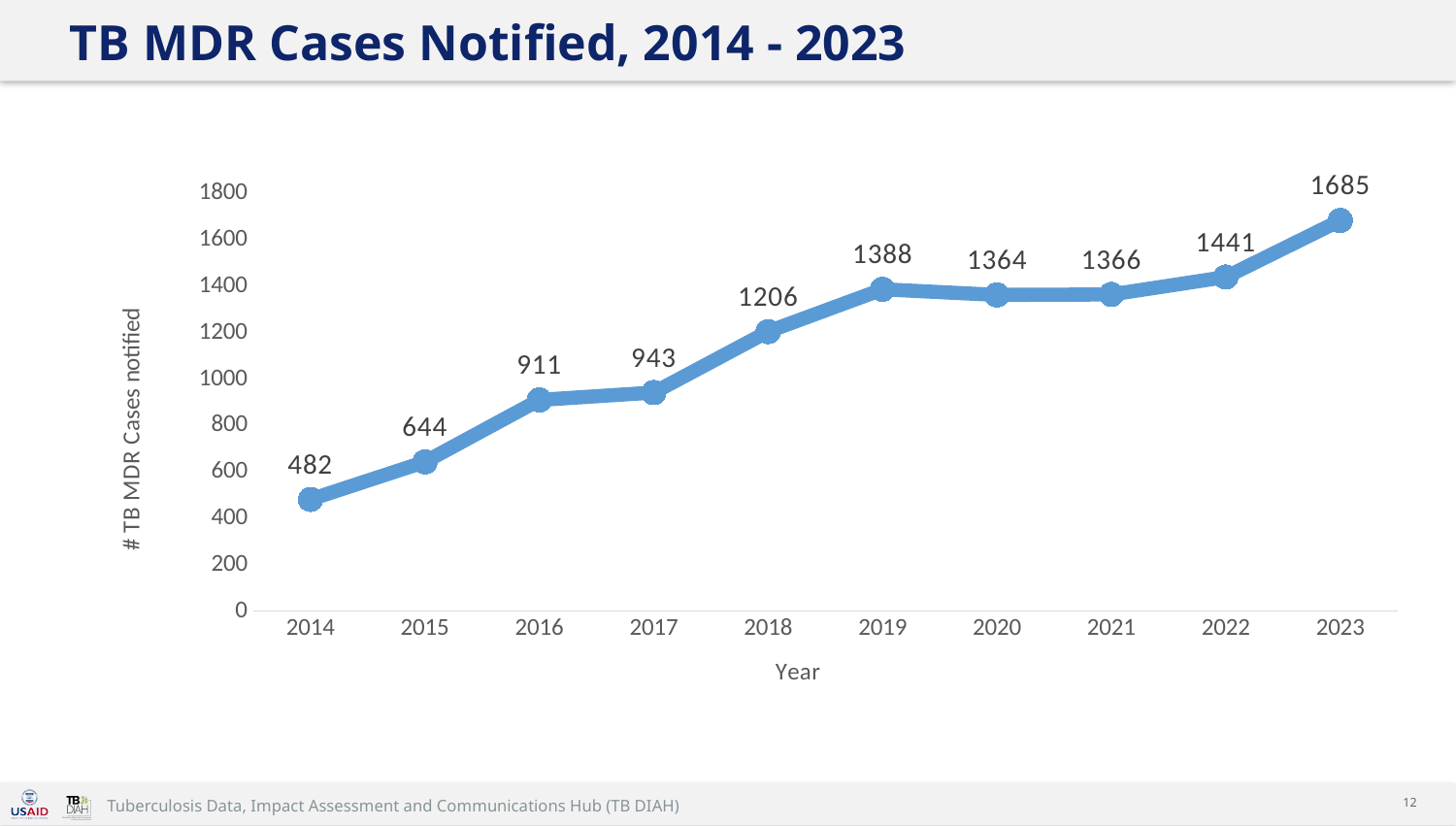
Which year had more TB MDR cases notified, 2016 or 2018? 2018 Which year has the lowest number of TB MDR cases notified? 2014 Which year has the highest number of TB MDR cases notified? 2023 What is the difference between the number of cases notified in 2023 and in 2014? 1203 What value is shown for 2022? 1441 What is the overall trend in TB MDR cases notified from 2014 to 2023? Rising How many years are plotted on the chart? 10 How many TB MDR cases were notified in 2014? 482 What kind of chart is shown on the slide? Line chart Is the value for 2015 greater or less than 800? less By how much did the number of cases notified increase from 2017 to 2018? 263 What is the number of TB MDR cases notified in 2019? 1388